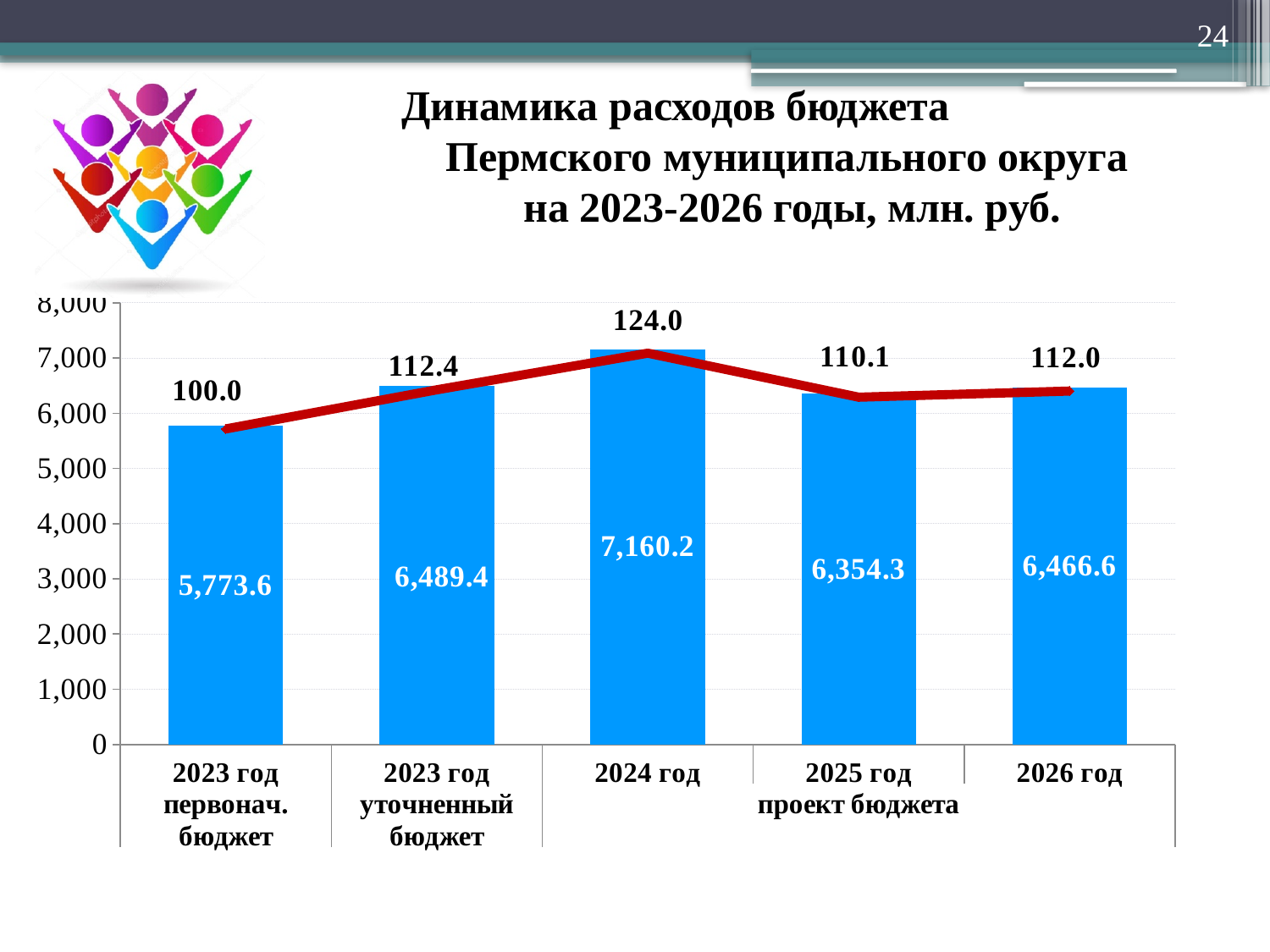
Which category has the lowest bar value? 2023 год первонач. бюджет What is the line (index) value shown above the 2024 год bar? 124.0 What is the title of the chart on the slide? Динамика расходов бюджета Пермского муниципального округа на 2023-2026 годы, млн. руб. Which year has the highest bar value? 2024 год What is the difference between the bar values for 2023 год уточненный бюджет and 2023 год первонач. бюджет? 715.8 What is the line (index) value shown above the 2025 год bar? 110.1 What value is printed on the bar for 2026 год? 6,466.6 What kind of chart is shown on the slide? Combined bar and line chart What is the budget expenditure value shown on the bar for 2024 год? 7,160.2 Which is larger, the bar value for 2025 год or for 2026 год? 2026 год How many bars are plotted in the chart? 5 What value is printed on the bar for 2023 год первонач. бюджет? 5,773.6